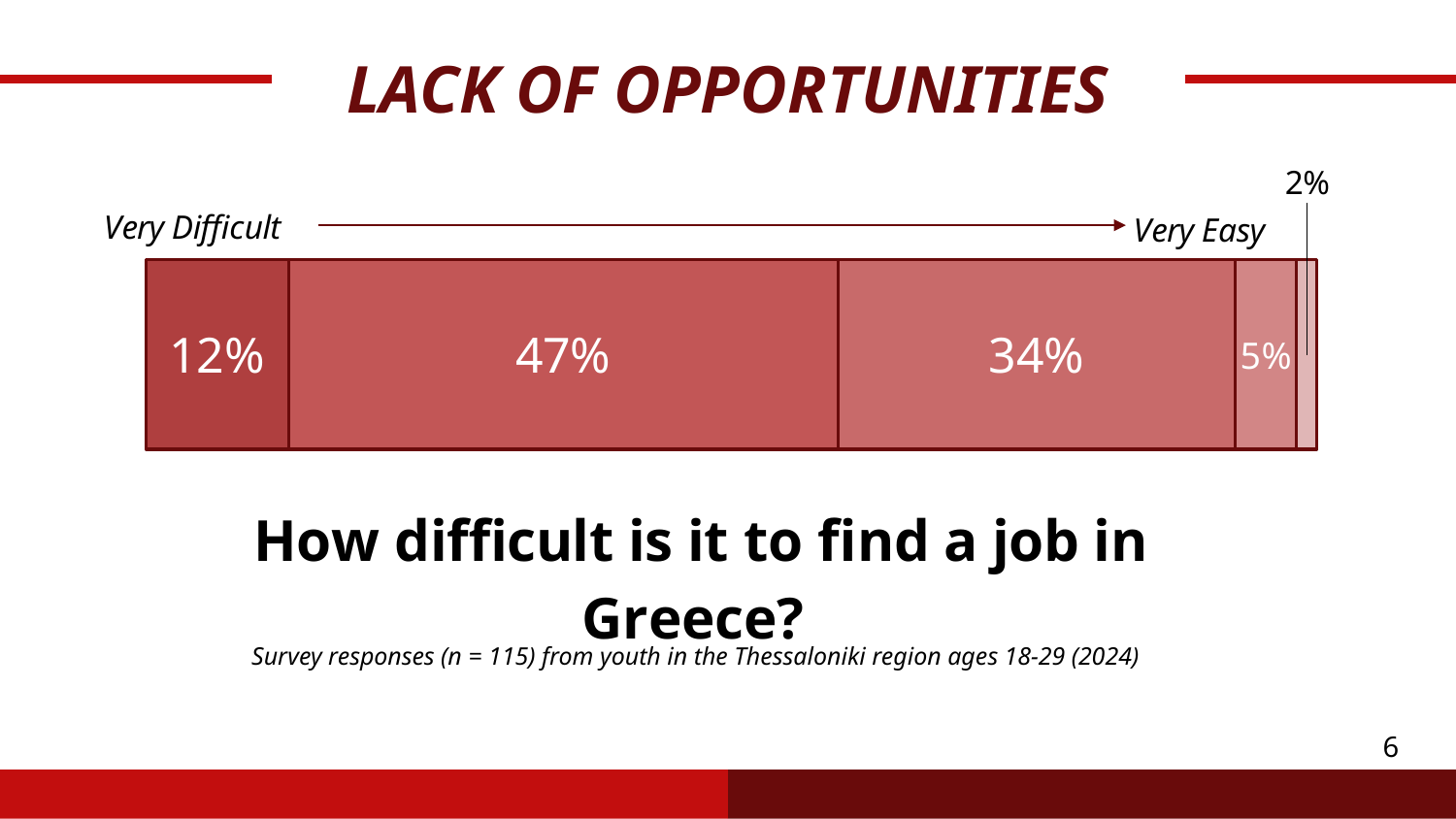
What percentage is shown in the third segment from the left? 34% Which segment of the bar is the largest? 47% Which is larger, the leftmost segment or the third segment from the left? The third segment (34%) How many segments make up the stacked bar? 5 What is the difference between the second segment (47%) and the third segment (34%)? 13% Which segment of the bar is the smallest? 2% What labels mark the two ends of the scale above the bar? Very Difficult and Very Easy What kind of chart is shown on the slide? Stacked bar chart What percentage is shown in the leftmost segment, at the 'Very Difficult' end of the bar? 12% What percentage is shown in the segment at the 'Very Easy' end of the bar? 2% What is the total of all segments in the stacked bar? 100% What percentage is shown in the second segment from the left? 47%